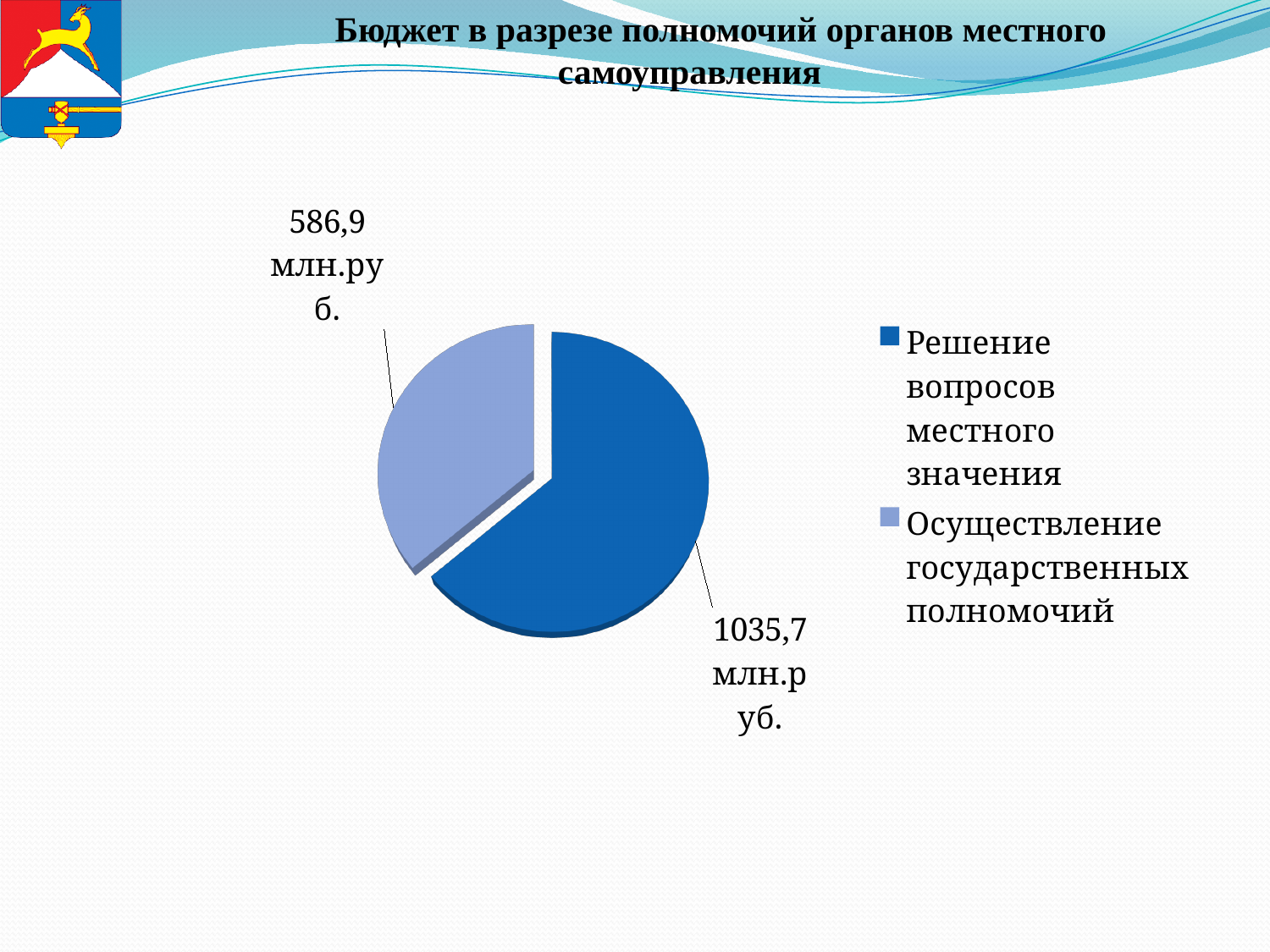
Which category has the largest slice of the pie? Решение вопросов местного значения Which colour represents "Осуществление государственных полномочий" in the pie chart? light blue What is the value for "Решение вопросов местного значения"? 1035,7 млн.руб. What is the title of the slide containing the chart? Бюджет в разрезе полномочий органов местного самоуправления How many entries does the legend list? 2 What is the total of the two slices in the pie chart? 1622,6 млн.руб. Which category has the smallest slice of the pie? Осуществление государственных полномочий How many slices does the pie chart have? 2 What is the value for "Осуществление государственных полномочий"? 586,9 млн.руб. Which is larger: "Решение вопросов местного значения" or "Осуществление государственных полномочий"? Решение вопросов местного значения What is the difference between the values for "Решение вопросов местного значения" and "Осуществление государственных полномочий"? 448,8 млн.руб. What kind of chart is shown on the slide? pie chart